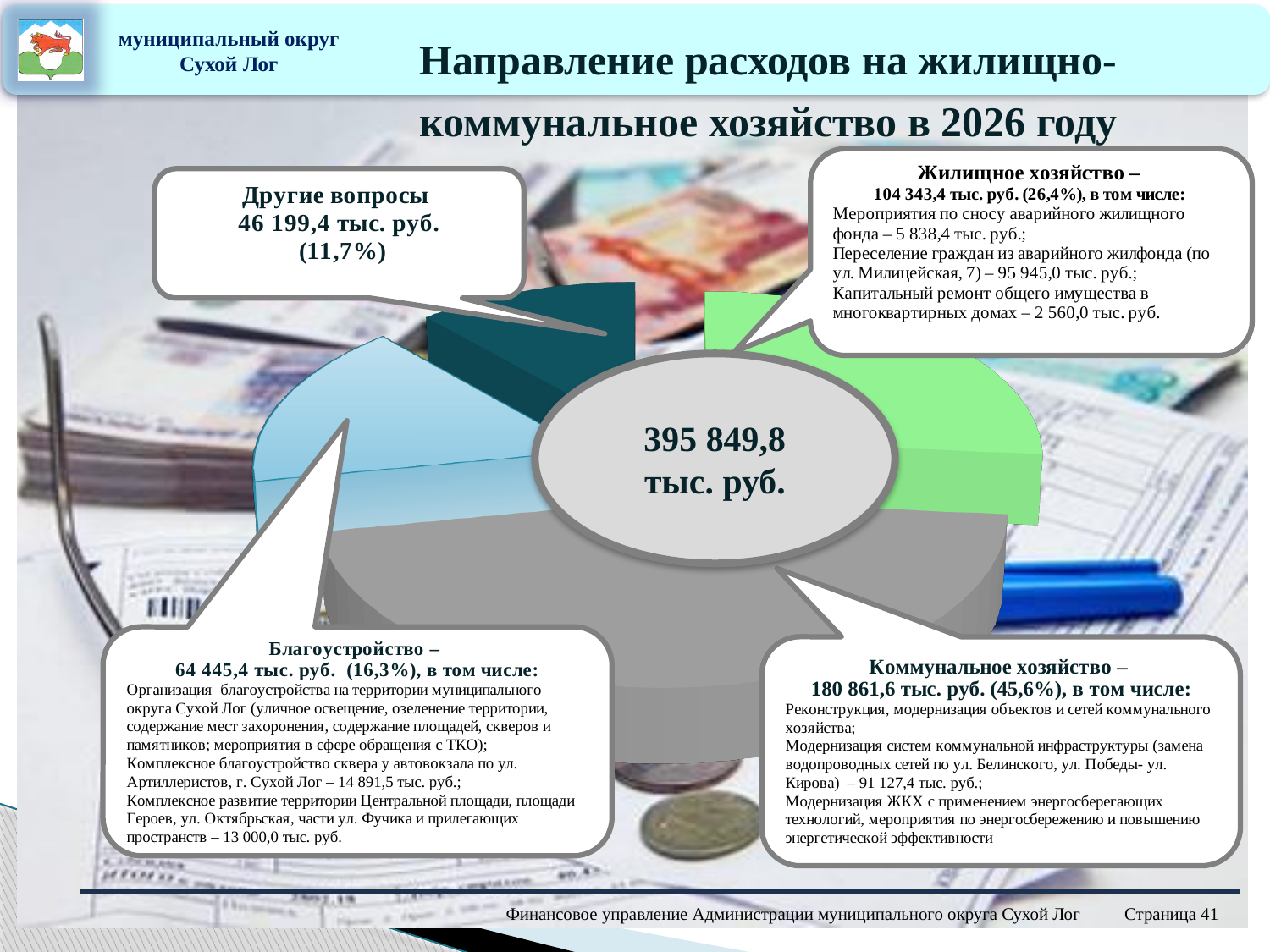
What is the value for Благоустройство? 64 445,4 тыс. руб. What kind of chart is shown on the slide? pie chart What share of the pie does Жилищное хозяйство represent? 26,4% How many slices does the pie chart have? 4 What share of the pie does Благоустройство represent? 16,3% What is the value for Коммунальное хозяйство? 180 861,6 тыс. руб. Which category has the smallest share of the pie? Другие вопросы What is the value for Жилищное хозяйство? 104 343,4 тыс. руб. What total amount is shown in the centre of the pie chart? 395 849,8 тыс. руб. Which category has the largest share of the pie? Коммунальное хозяйство What is the value for Другие вопросы? 46 199,4 тыс. руб. Which is larger, Жилищное хозяйство or Благоустройство? Жилищное хозяйство